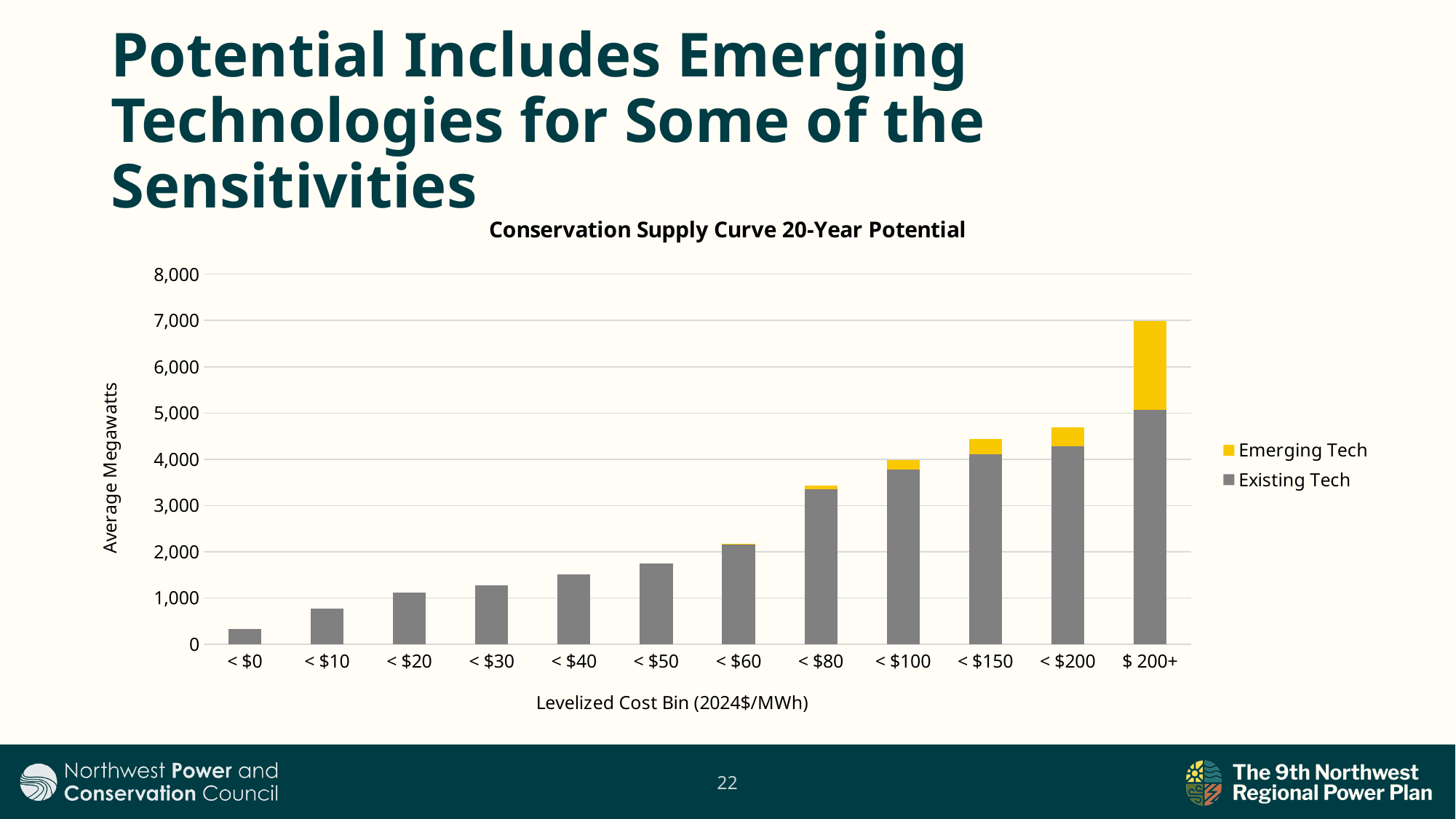
Which levelized cost bin has the shortest bar? < $0 Is the value for the < $0 bin greater or less than 1,000? less How many levelized cost bins are shown on the x axis? 12 What is the title of the chart? Conservation Supply Curve 20-Year Potential Which levelized cost bin has the tallest bar? $ 200+ Is the value for the < $40 bin greater or less than 1,000? greater Is the total value for the < $100 bin greater or less than 3,000? greater Which colour represents Emerging Tech in the legend? yellow How many series does the legend list? 2 What kind of chart is shown on the slide? bar chart Do the bar heights rise or fall as the levelized cost bin increases along the x axis? rise